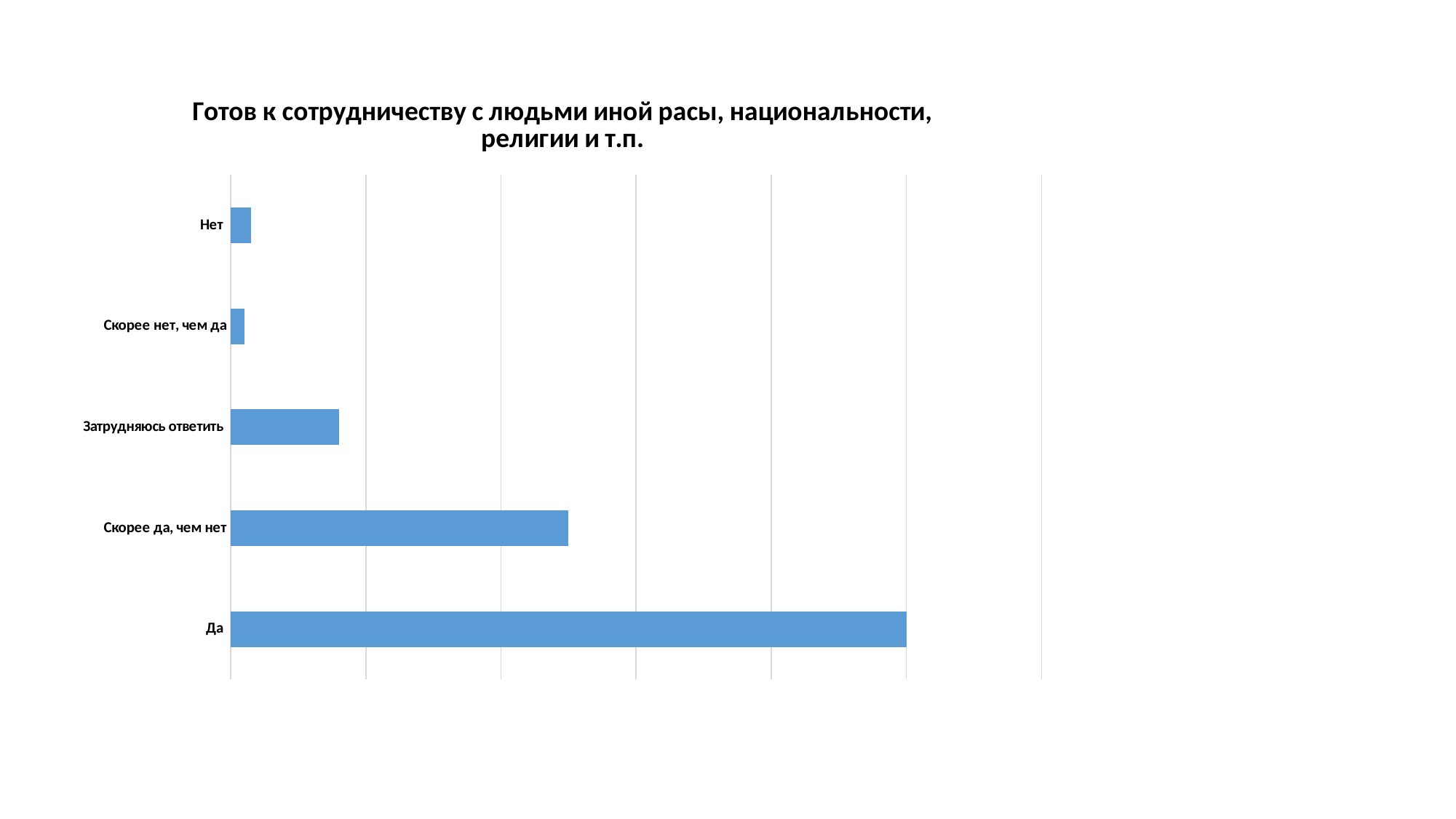
Which is larger, the value for "Скорее да, чем нет" or the value for "Затрудняюсь ответить"? Скорее да, чем нет Which is larger, the value for "Да" or the value for "Скорее да, чем нет"? Да How many categories are shown in the chart? 5 Which is larger, the value for "Да" or the value for "Скорее нет, чем да"? Да What is the title of the chart? Готов к сотрудничеству с людьми иной расы, национальности, религии и т.п. Which category is listed at the bottom of the chart? Да What kind of chart is shown on the slide? Bar chart Which category has the highest value? Да What colour are the bars in the chart? Blue